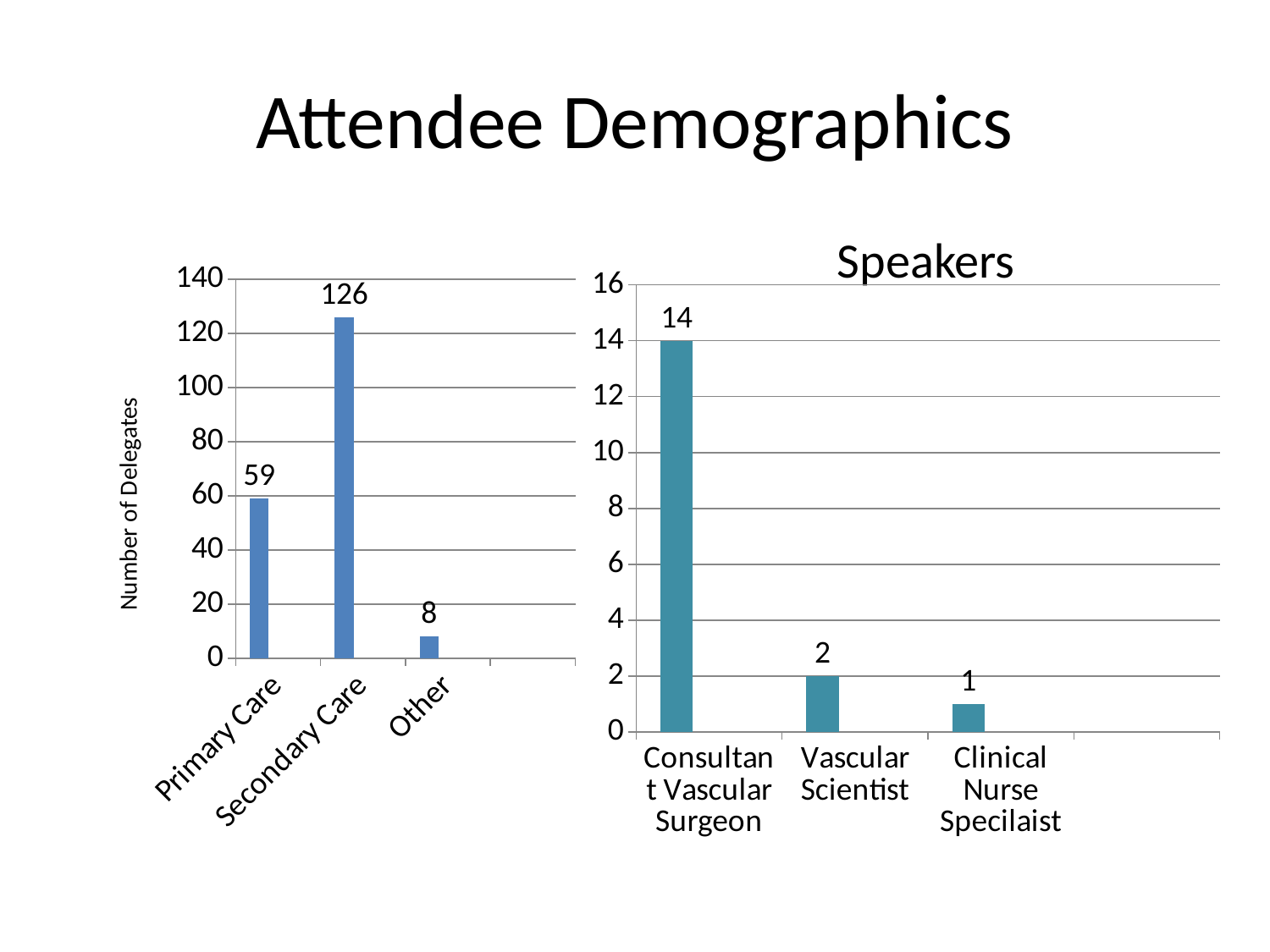
In the left chart (Number of Delegates), which category has the lowest value? Other In the left chart (Number of Delegates), what is the value for Primary Care? 59 What kind of chart is the Speakers chart? Bar chart In the Speakers chart, what is the value for Clinical Nurse Specilaist? 1 In the Speakers chart, what is the difference between Consultant Vascular Surgeon and Vascular Scientist? 12 In the Speakers chart, what is the value for Consultant Vascular Surgeon? 14 In the left chart (Number of Delegates), what is the difference between Secondary Care and Primary Care? 67 In the Speakers chart, which is larger, Vascular Scientist or Clinical Nurse Specilaist? Vascular Scientist In the left chart (Number of Delegates), what is the total of all three categories? 193 In the left chart (Number of Delegates), what is the value for Secondary Care? 126 In the left chart (Number of Delegates), how many categories are shown? 3 In the Speakers chart, which category has the highest value? Consultant Vascular Surgeon